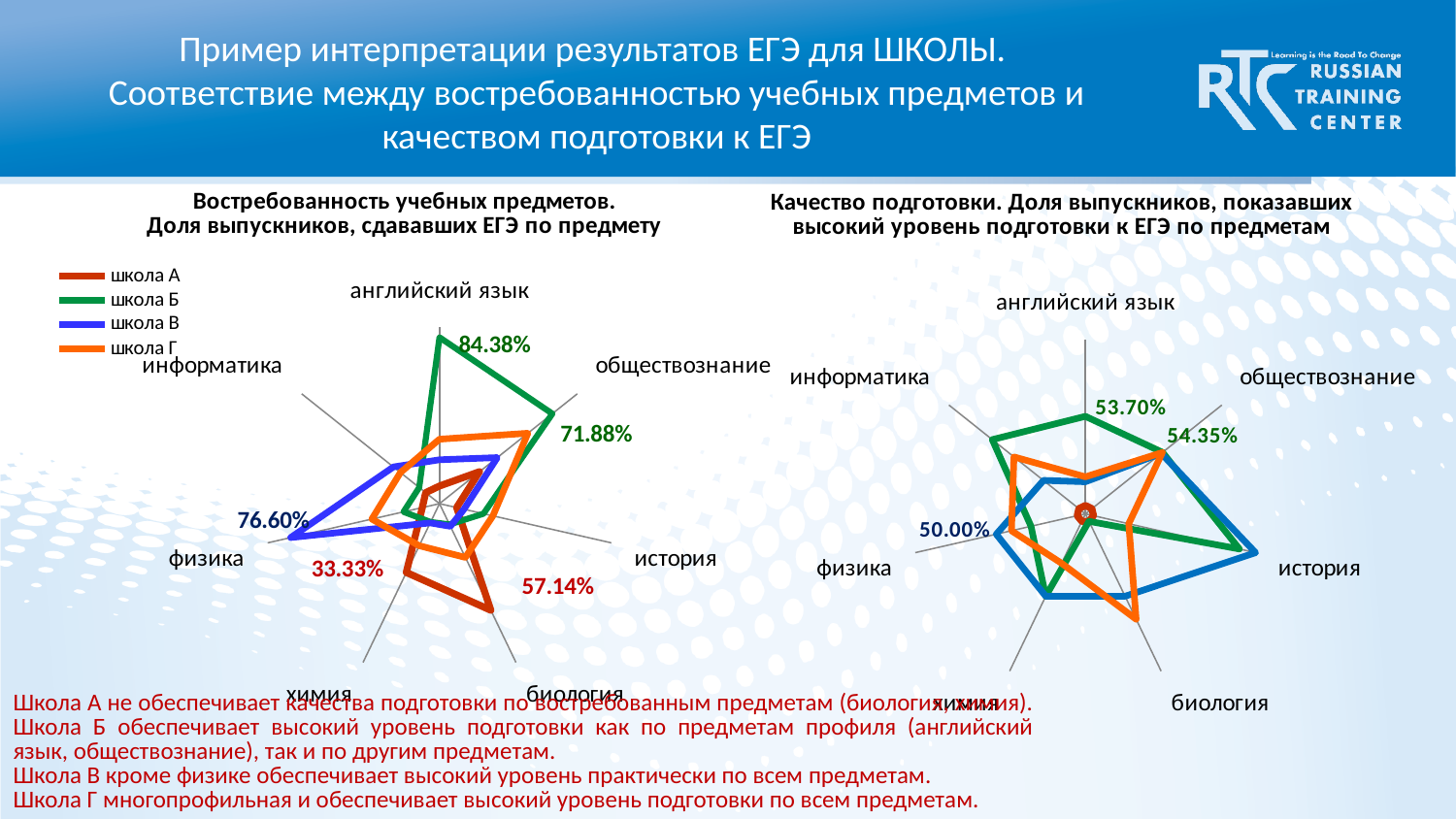
On the right chart titled "Качество подготовки", what is the labelled value for школа Б for английский язык? 53.70% What kind of chart is the left chart titled "Востребованность учебных предметов"? radar chart On the left chart, what is the labelled value for школа В for физика? 76.60% On the left chart, what is the labelled value for школа Б for английский язык? 84.38% On the left chart, which colour represents школа Г in the legend? orange On the left chart, what is the difference between школа Б's labelled values for английский язык and обществознание? 12.50% How many subject categories are plotted on the left chart? 7 On the left chart, which is larger for школа Б: the value for английский язык or for обществознание? английский язык On the left chart, what is the labelled value for школа Б for обществознание? 71.88% On the left chart, what is the labelled value for школа А for биология? 57.14% How many series does the legend of the left chart list? 4 On the right chart, what is the labelled value for школа В for физика? 50.00%